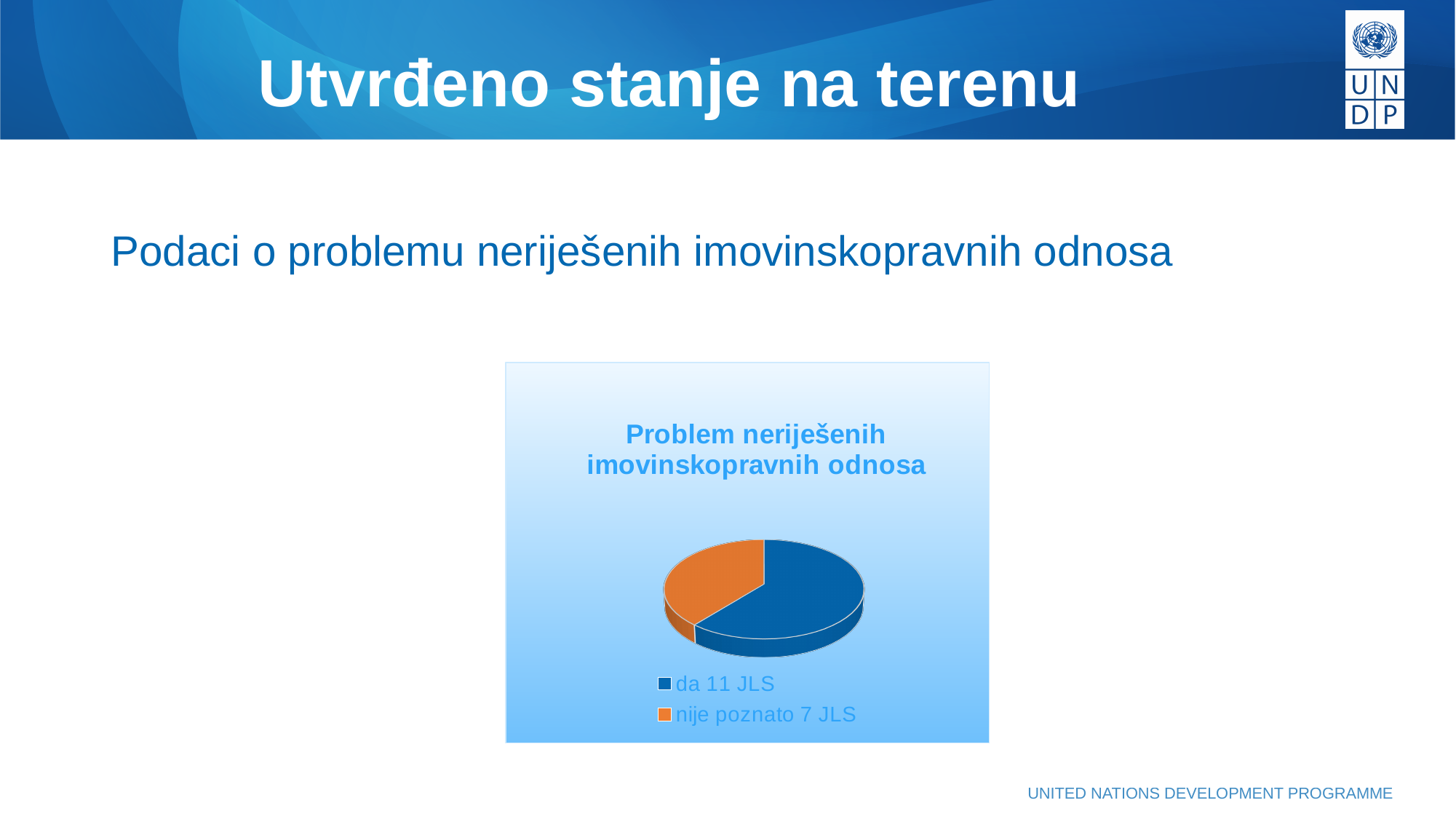
What is the title of the chart? Problem neriješenih imovinskopravnih odnosa What colour is the 'nije poznato' slice? orange What is the total number of JLS across both slices of the pie? 18 How many JLS are in the 'nije poznato' category? 7 JLS Which category has the smallest slice of the pie? nije poznato How many slices does the pie chart have? 2 What kind of chart is shown on the slide? pie chart What is the difference in JLS between the 'da' and 'nije poznato' categories? 4 Which is larger, the 'da' slice or the 'nije poznato' slice? da How many entries does the chart legend list? 2 Which category has the largest slice of the pie? da How many JLS are in the 'da' category? 11 JLS